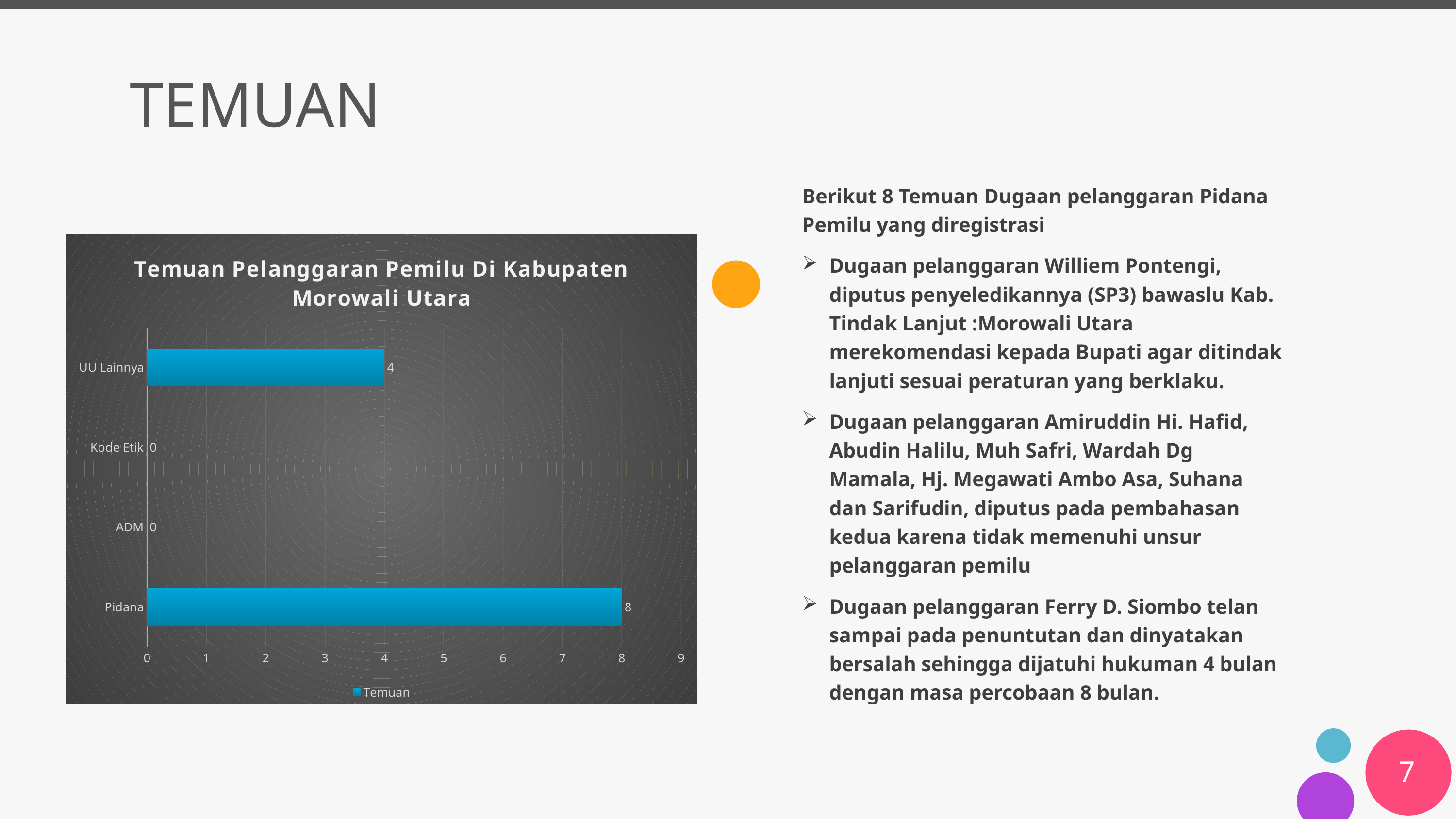
What is the difference between the values for Pidana and UU Lainnya? 4 What kind of chart is shown on the slide? Bar chart How many series does the chart legend list? 1 Is the value for Pidana greater or less than 5? greater What is the value for ADM in the chart? 0 Which is larger, the value for Pidana or the value for UU Lainnya? Pidana What is the value for Kode Etik in the chart? 0 Which category has the highest value in the chart? Pidana How many categories are shown in the chart? 4 What is the value for Pidana in the chart? 8 What is the value for UU Lainnya in the chart? 4 What is the title of the chart? Temuan Pelanggaran Pemilu Di Kabupaten Morowali Utara